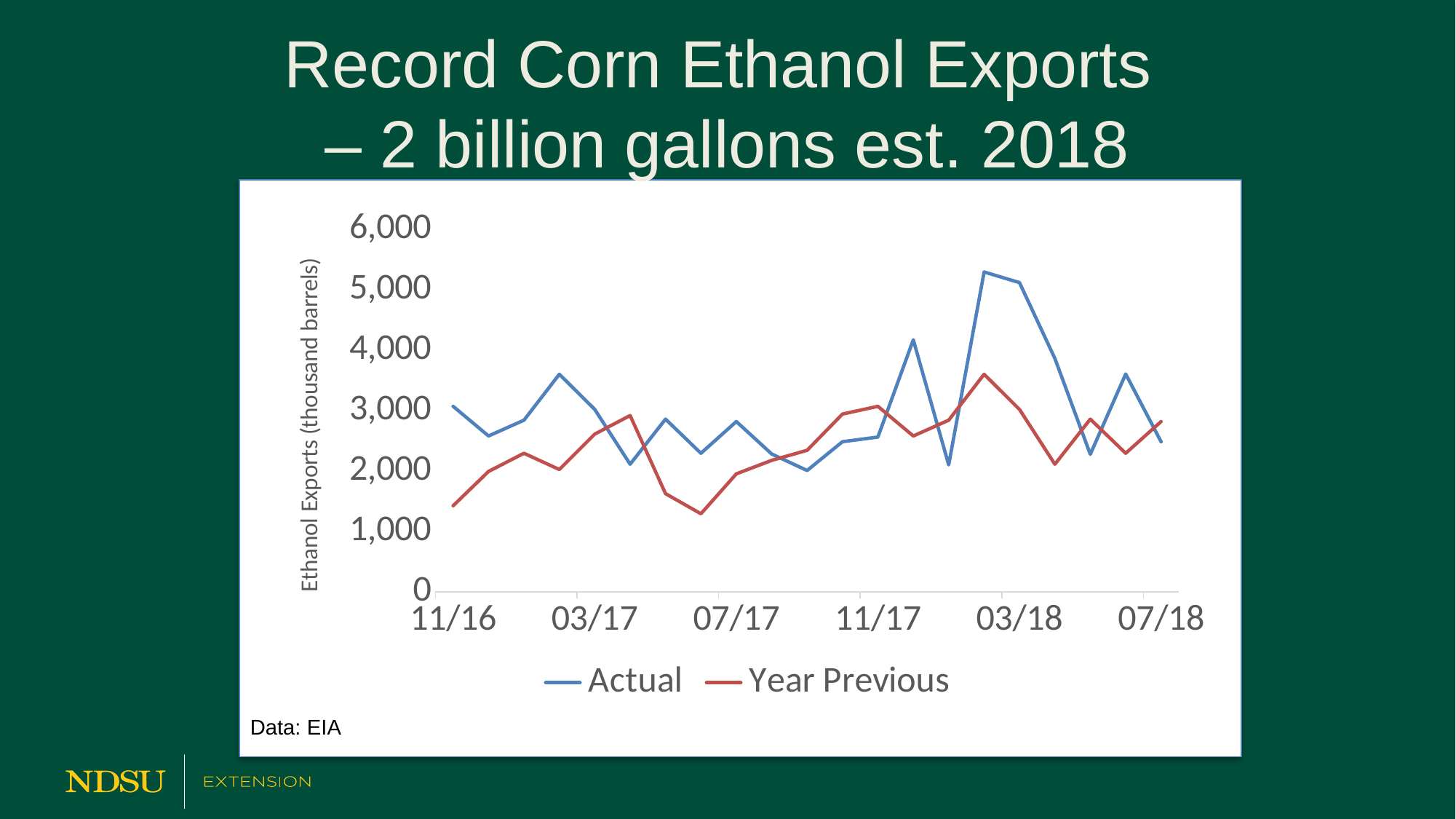
How many date labels are shown along the chart's x axis? 6 Is the Year Previous value at 11/16 greater or less than 2,000? less Is the Actual value at 03/18 greater or less than 4,000? greater Is the Actual value at 07/18 greater or less than 3,000? less How many series does the chart's legend list? 2 What is the label on the chart's vertical axis? Ethanol Exports (thousand barrels) At 03/18, which series has the larger value, Actual or Year Previous? Actual At 11/16, which series has the larger value, Actual or Year Previous? Actual What kind of chart is shown on the slide? Line chart What are the two series named in the chart's legend? Actual and Year Previous